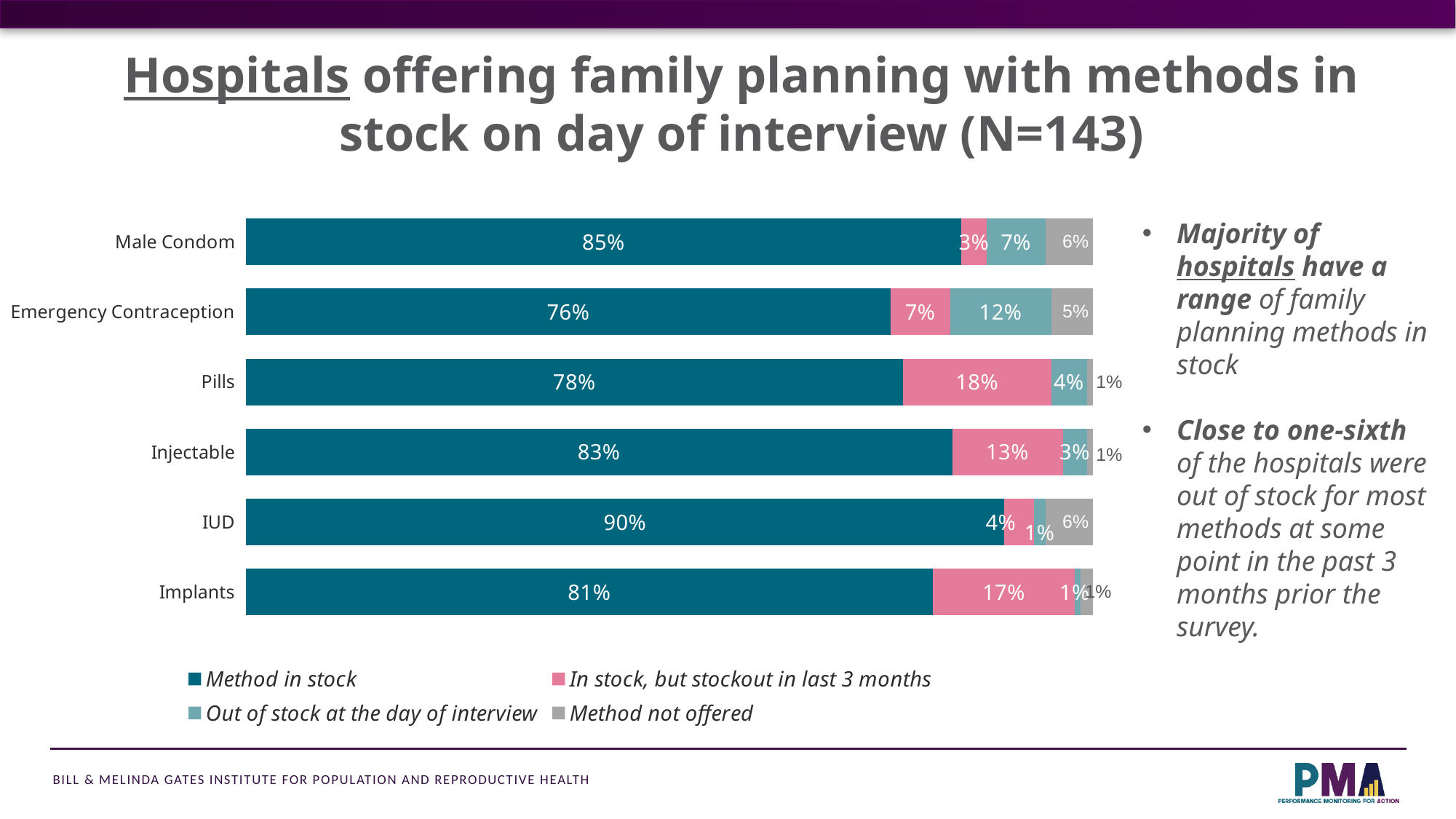
What is the value for 'Out of stock at the day of interview' for Emergency Contraception? 12% Which method has the lowest 'Method in stock' percentage? Emergency Contraception What is the sample size (N) stated in the slide title? 143 What is the value for 'In stock, but stockout in last 3 months' for Pills? 18% What percentage of hospitals had the IUD in stock (Method in stock) on the day of interview? 90% How many series does the legend list? 4 What is the 'Method not offered' value for Male Condom? 6% What type of chart is shown on the slide? Stacked bar chart Which method has the highest 'Method in stock' percentage? IUD Which has a larger 'In stock, but stockout in last 3 months' value, Pills or Implants? Pills What is the difference in 'Method in stock' percentage between Male Condom and Injectable? 2 percentage points How many family planning methods are shown in the chart? 6